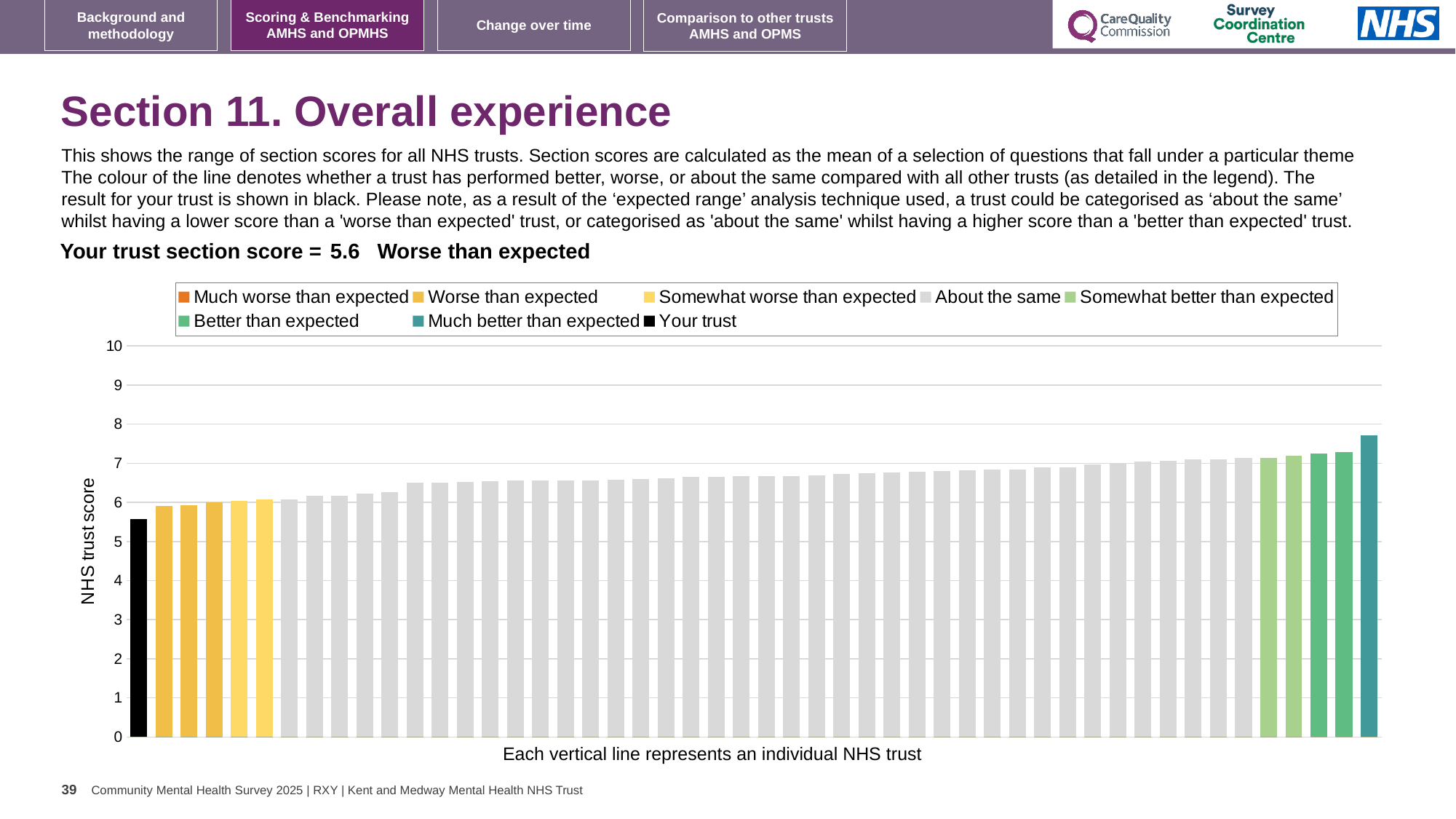
What is the section score for your trust shown on the slide? 5.6 Is the value for your trust (the black bar) greater or less than 6? less What is the label on the vertical axis of the chart? NHS trust score Which bar has the lowest value in the chart? Your trust (the black bar) Is the value of the tallest bar greater or less than 8? less How many entries does the chart legend list? 8 Which legend category does the tallest bar belong to? Much better than expected What does each vertical line in the chart represent, according to the x-axis label? an individual NHS trust Do the bar values rise or fall from left to right along the x axis? rise Is the value of the tallest bar greater or less than 7? greater Which category is your trust's section score placed in, according to the text above the chart? Worse than expected What kind of chart is shown on the slide? bar chart